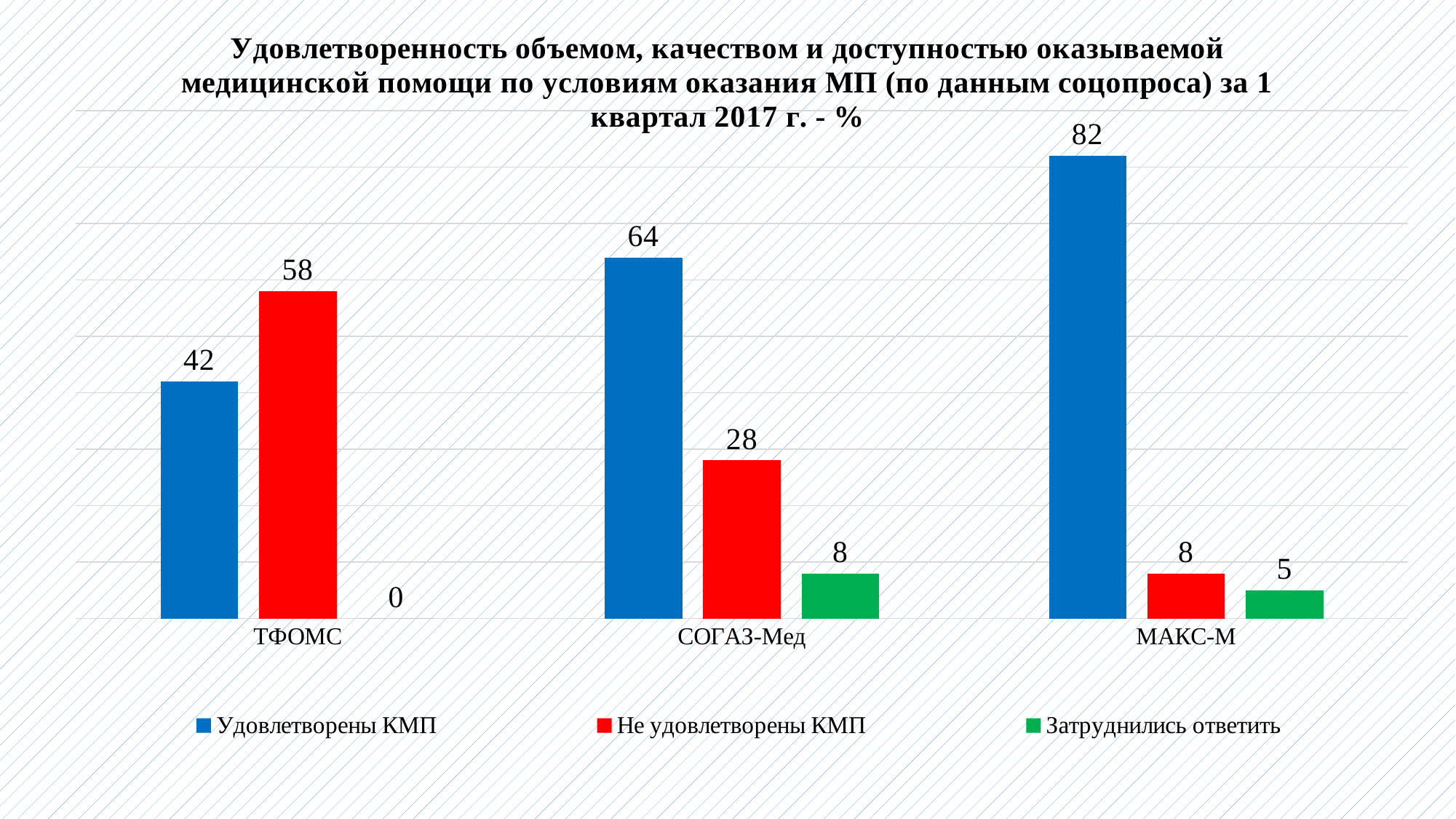
What is the value for 'Не удовлетворены КМП' for СОГАЗ-Мед? 28 What is the difference between 'Удовлетворены КМП' for МАКС-М and for ТФОМС? 40 Which colour represents the 'Затруднились ответить' series? Green What is the value for 'Удовлетворены КМП' for ТФОМС? 42 What kind of chart is shown on the slide? Bar chart What is the value for 'Затруднились ответить' for МАКС-М? 5 For ТФОМС, which is larger: 'Удовлетворены КМП' or 'Не удовлетворены КМП'? Не удовлетворены КМП What is the value for 'Затруднились ответить' for ТФОМС? 0 Which category has the highest value for 'Удовлетворены КМП'? МАКС-М How many series does the legend list? 3 How many categories are shown on the x axis? 3 Which category has the lowest value for 'Не удовлетворены КМП'? МАКС-М